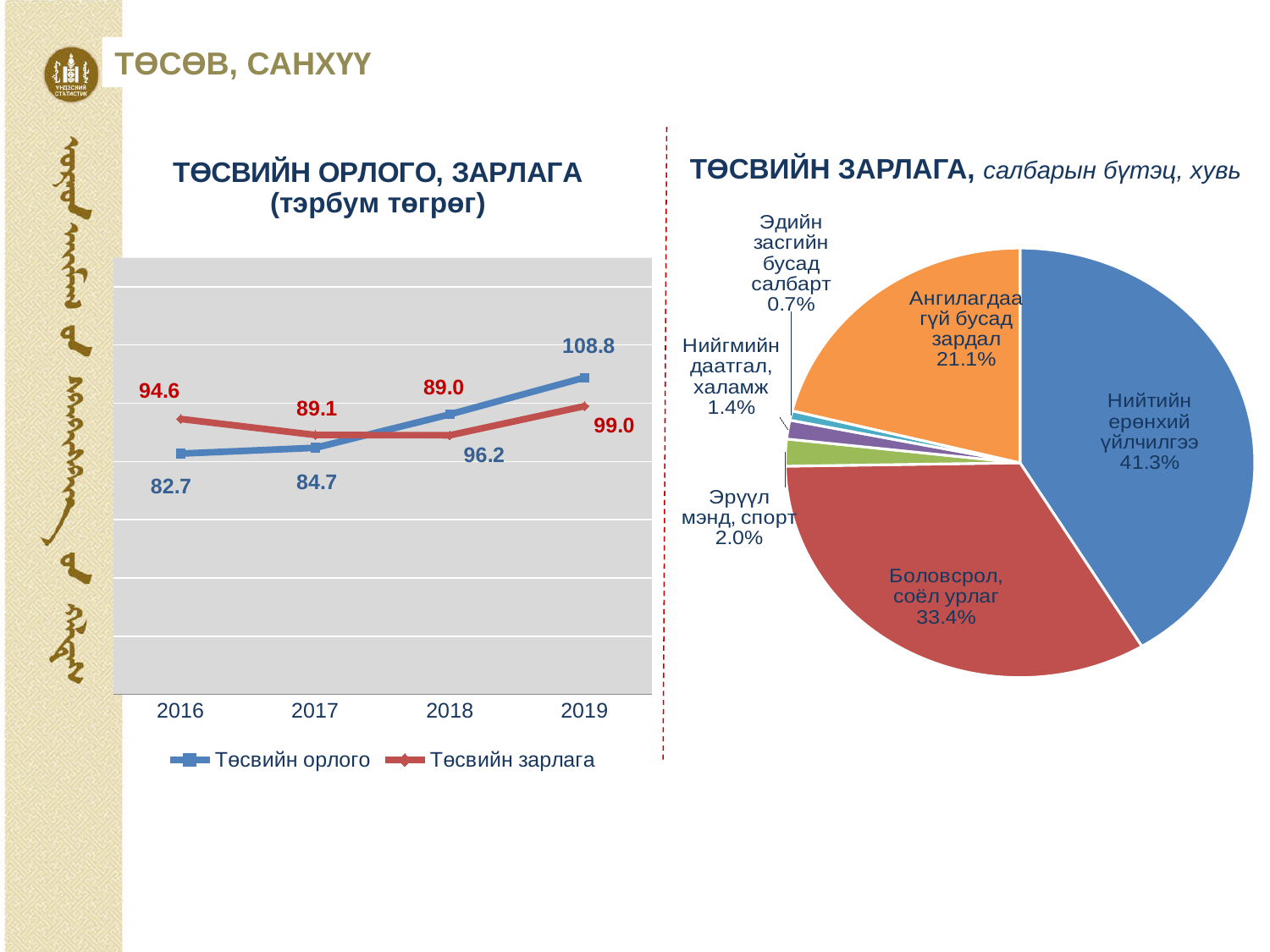
How many series does the legend of the line chart 'ТӨСВИЙН ОРЛОГО, ЗАРЛАГА (тэрбум төгрөг)' list? 2 In the line chart 'ТӨСВИЙН ОРЛОГО, ЗАРЛАГА (тэрбум төгрөг)', in which year is Төсвийн зарлага highest? 2019 In the pie chart 'ТӨСВИЙН ЗАРЛАГА, салбарын бүтэц, хувь', what share does Боловсрол, соёл урлаг have? 33.4% In the line chart 'ТӨСВИЙН ОРЛОГО, ЗАРЛАГА (тэрбум төгрөг)', what is the difference between Төсвийн орлого and Төсвийн зарлага in 2019? 9.8 In the line chart 'ТӨСВИЙН ОРЛОГО, ЗАРЛАГА (тэрбум төгрөг)', in which year is Төсвийн орлого lowest? 2016 In the line chart 'ТӨСВИЙН ОРЛОГО, ЗАРЛАГА (тэрбум төгрөг)', does Төсвийн орлого rise or fall from 2016 to 2019? rise In the line chart 'ТӨСВИЙН ОРЛОГО, ЗАРЛАГА (тэрбум төгрөг)', what is the value of Төсвийн зарлага in 2016? 94.6 In the pie chart 'ТӨСВИЙН ЗАРЛАГА, салбарын бүтэц, хувь', which slice is the largest? Нийтийн ерөнхий үйлчилгээ How many years are shown on the x axis of the line chart 'ТӨСВИЙН ОРЛОГО, ЗАРЛАГА (тэрбум төгрөг)'? 4 In the line chart 'ТӨСВИЙН ОРЛОГО, ЗАРЛАГА (тэрбум төгрөг)', which is larger in 2017: Төсвийн орлого or Төсвийн зарлага? Төсвийн зарлага In the line chart 'ТӨСВИЙН ОРЛОГО, ЗАРЛАГА (тэрбум төгрөг)', what is the value of Төсвийн орлого in 2019? 108.8 What kind of chart is 'ТӨСВИЙН ЗАРЛАГА, салбарын бүтэц, хувь'? pie chart